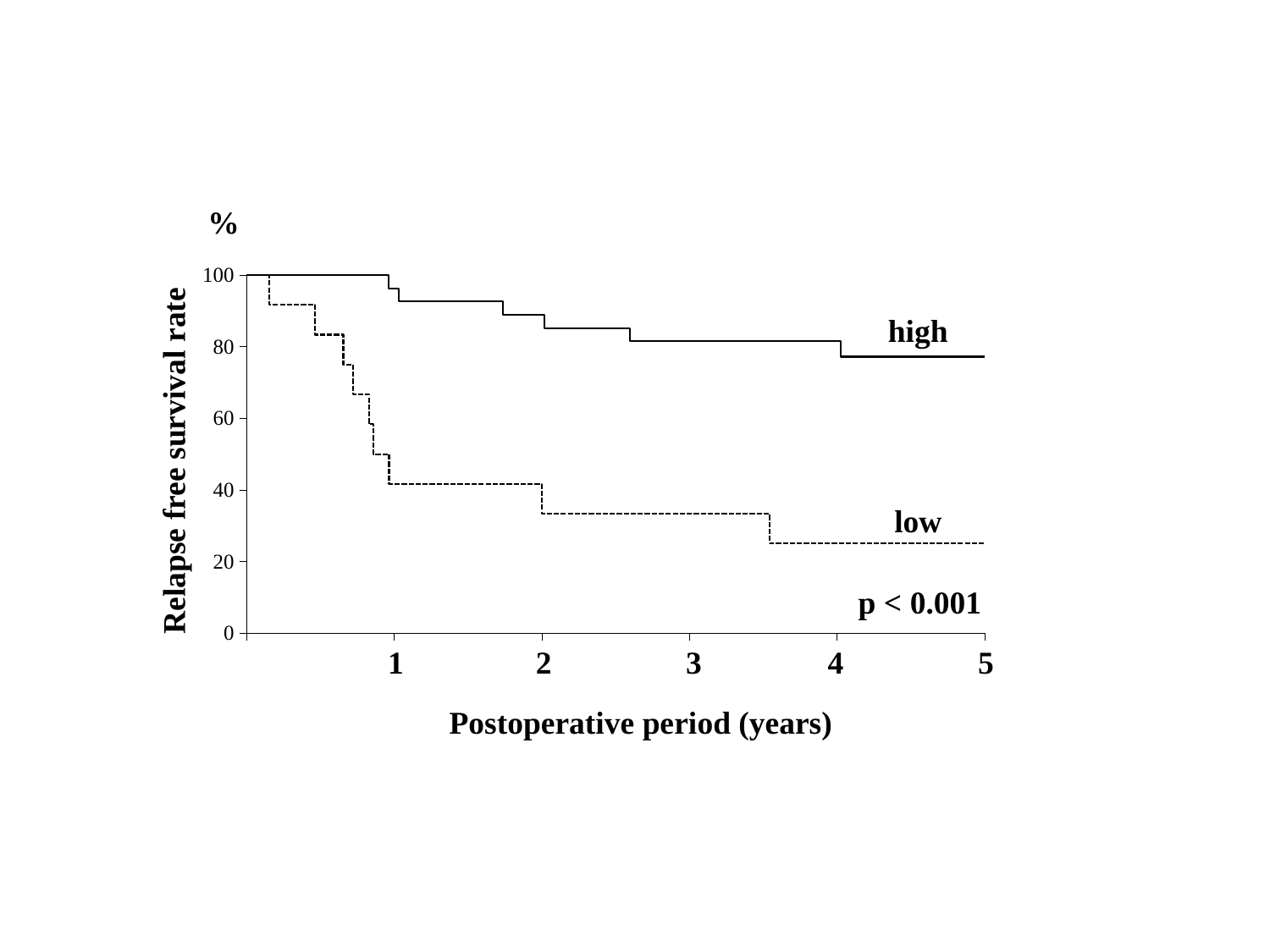
How many series (groups) are plotted on the chart? 2 Is the relapse free survival rate for the high group at 3 years greater or less than 60? greater Which group has the higher relapse free survival rate at 5 years, high or low? high What are the names of the two groups plotted on the chart? high and low What p-value is printed on the chart? p < 0.001 What kind of chart is shown on the slide? line chart Do the relapse free survival rates rise or fall as the postoperative period increases? fall Is the relapse free survival rate for the high group at 5 years greater or less than 60? greater Which group has the lower relapse free survival rate at 2 years, high or low? low Is the relapse free survival rate for the low group at 5 years greater or less than 40? less What is the label of the x axis? Postoperative period (years)